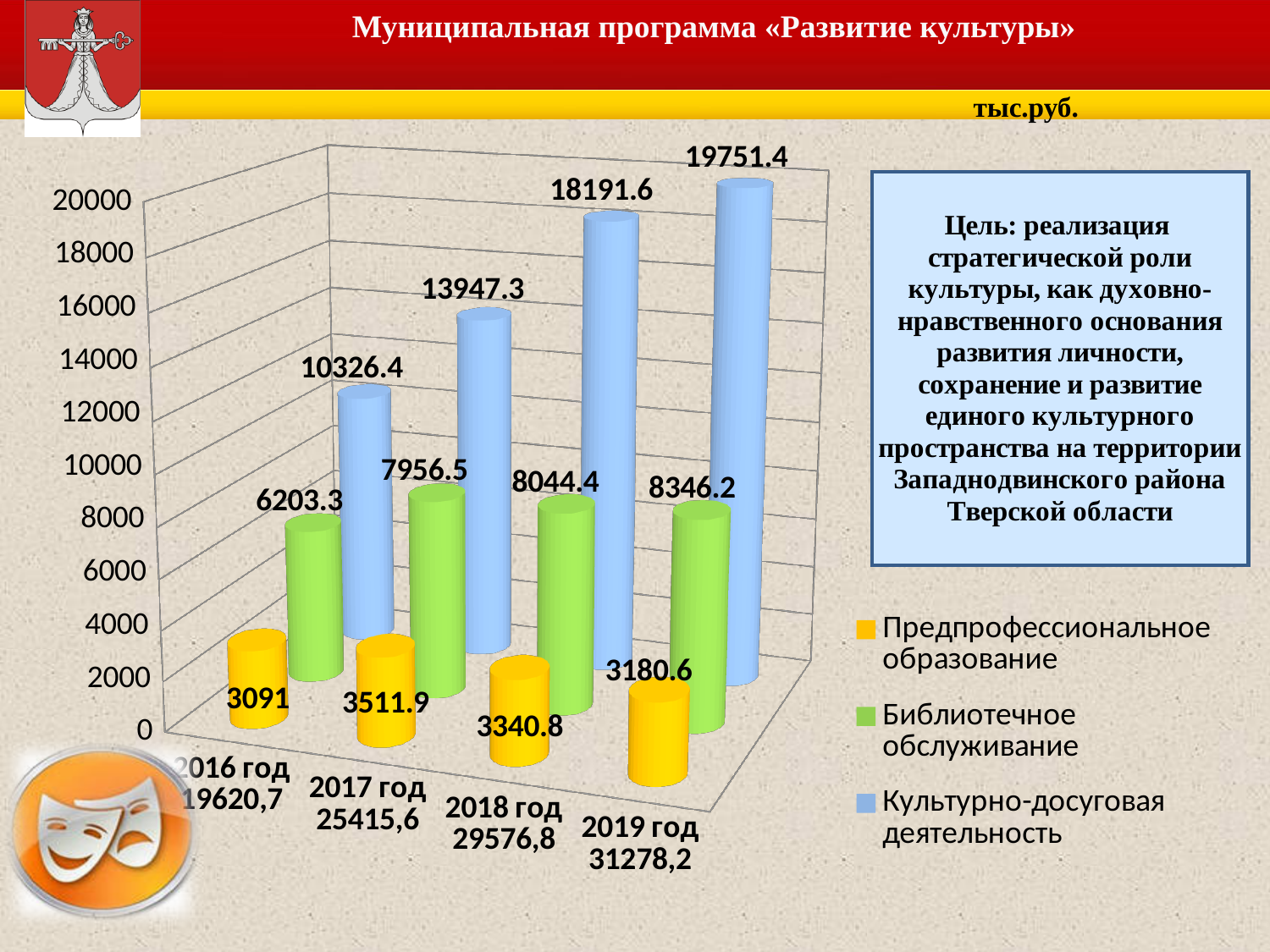
What kind of chart is shown on the slide? bar chart In which year is the value for Культурно-досуговая деятельность the highest? 2019 год How many series does the legend list? 3 In which year is the value for Предпрофессиональное образование the lowest? 2016 год What is the difference between the Культурно-досуговая деятельность values for 2018 год and 2017 год? 4244.3 Which is larger: Предпрофессиональное образование in 2017 год or in 2018 год? 2017 год Do the values for Библиотечное обслуживание rise or fall from 2016 год to 2019 год? rise How many years are shown on the x axis? 4 What is the value for Предпрофессиональное образование in 2016 год? 3091 What is the value for Библиотечное обслуживание in 2017 год? 7956.5 What is the value for Культурно-досуговая деятельность in 2019 год? 19751.4 Is the value for Культурно-досуговая деятельность in 2016 год greater or less than 12000? less